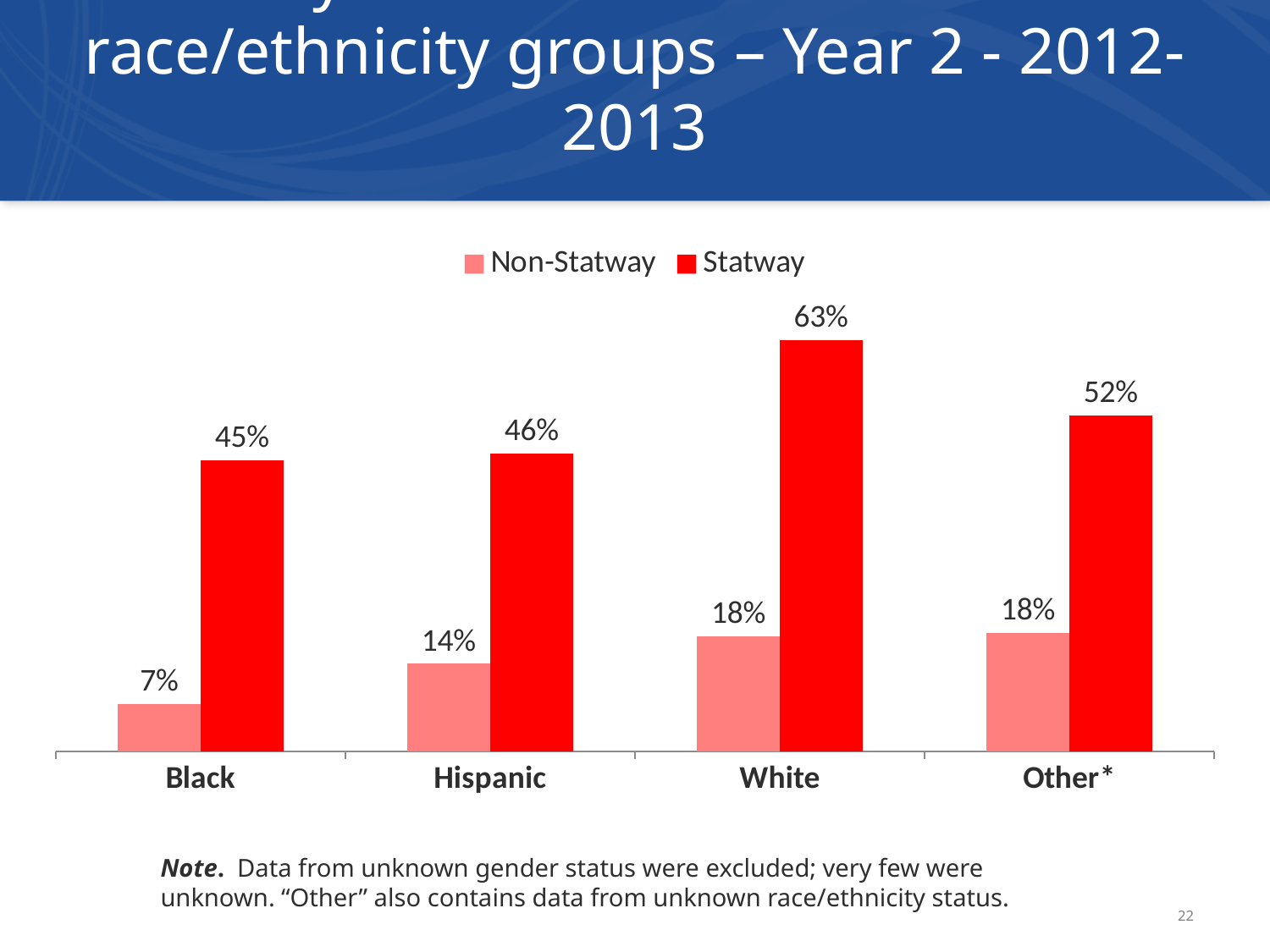
What kind of chart is shown on the slide? Bar chart What is the Statway value for White? 63% What is the difference between the Statway and Non-Statway values for Black? 38% How many race/ethnicity groups are shown on the x axis? 4 What is the difference between the Statway values for White and Other*? 11% Which race/ethnicity group has the highest Statway value? White What is the Non-Statway value for Black? 7% How many series does the legend list? 2 Which is larger: the Non-Statway value for Hispanic or the Non-Statway value for White? White What is the Statway value for Hispanic? 46% Which race/ethnicity group has the lowest Non-Statway value? Black What is the Non-Statway value for Other*? 18%